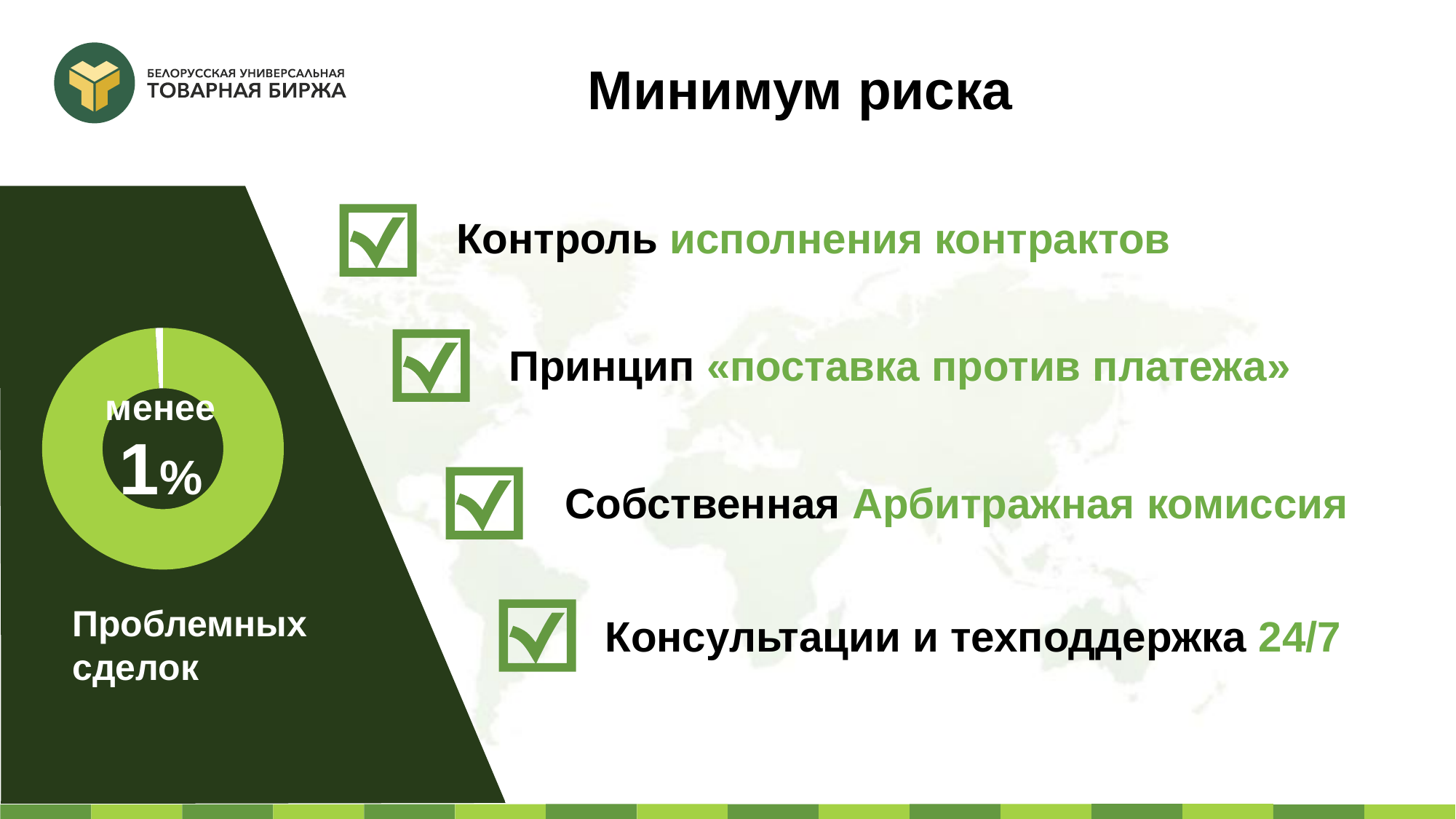
What does the doughnut chart on the slide represent, according to its caption? Проблемных сделок According to the chart, what share of deals are problem deals (Проблемных сделок)? менее 1% What kind of chart is shown on the left of the slide? doughnut chart Which segment of the doughnut chart is larger: the problem deals segment or the remaining segment? the remaining segment What is the title of the slide containing the doughnut chart? Минимум риска What value is printed in the centre of the doughnut chart? менее 1% How many segments does the doughnut chart show? 2